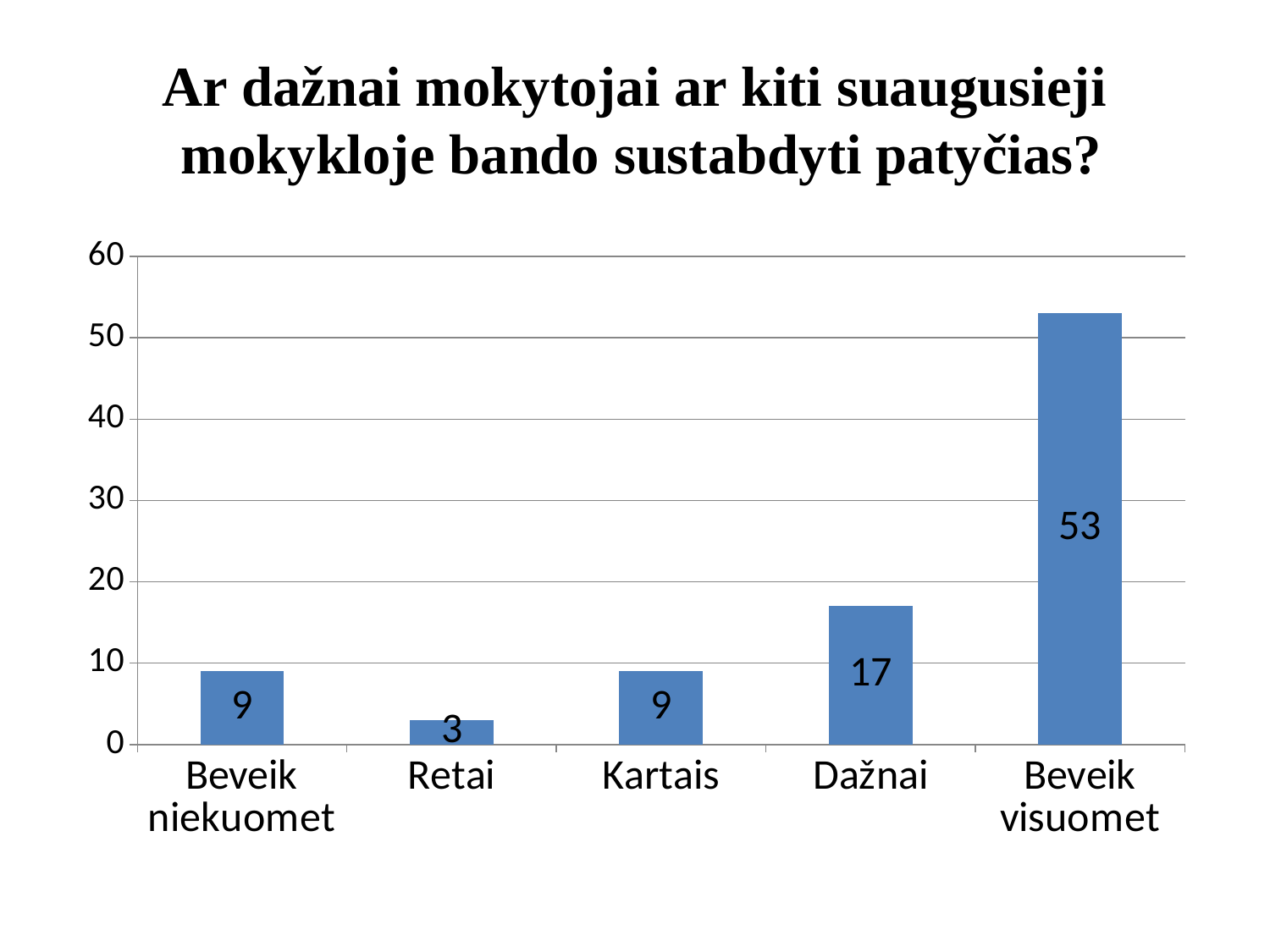
What is the value for Dažnai? 17 What is the value for Retai? 3 How many categories are shown on the x axis? 5 Which is larger, the value for Dažnai or the value for Kartais? Dažnai What is the value for Beveik visuomet? 53 What is the difference between the values for Kartais and Retai? 6 Which category has the lowest value? Retai What is the difference between the values for Beveik visuomet and Dažnai? 36 What kind of chart is shown on the slide? bar chart Which category has the highest value? Beveik visuomet Is the value for Beveik visuomet greater or less than 50? greater What is the title of the slide? Ar dažnai mokytojai ar kiti suaugusieji mokykloje bando sustabdyti patyčias?